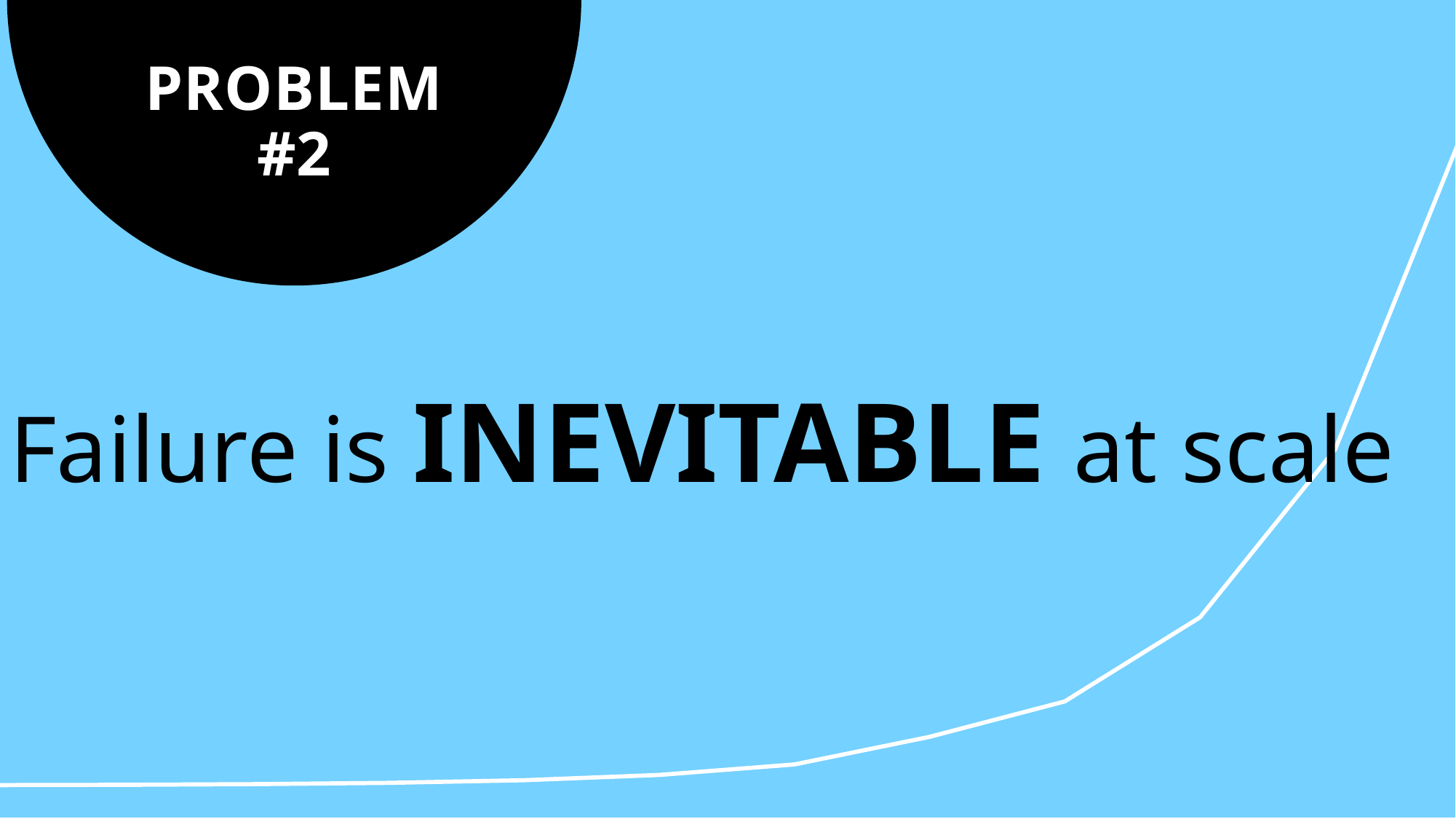
What kind of chart is drawn on the slide? line chart What colour is the plotted line on the slide? white Do the values of the line rise or fall from left to right? rise Does the line rise faster at the left or at the right of the slide? right